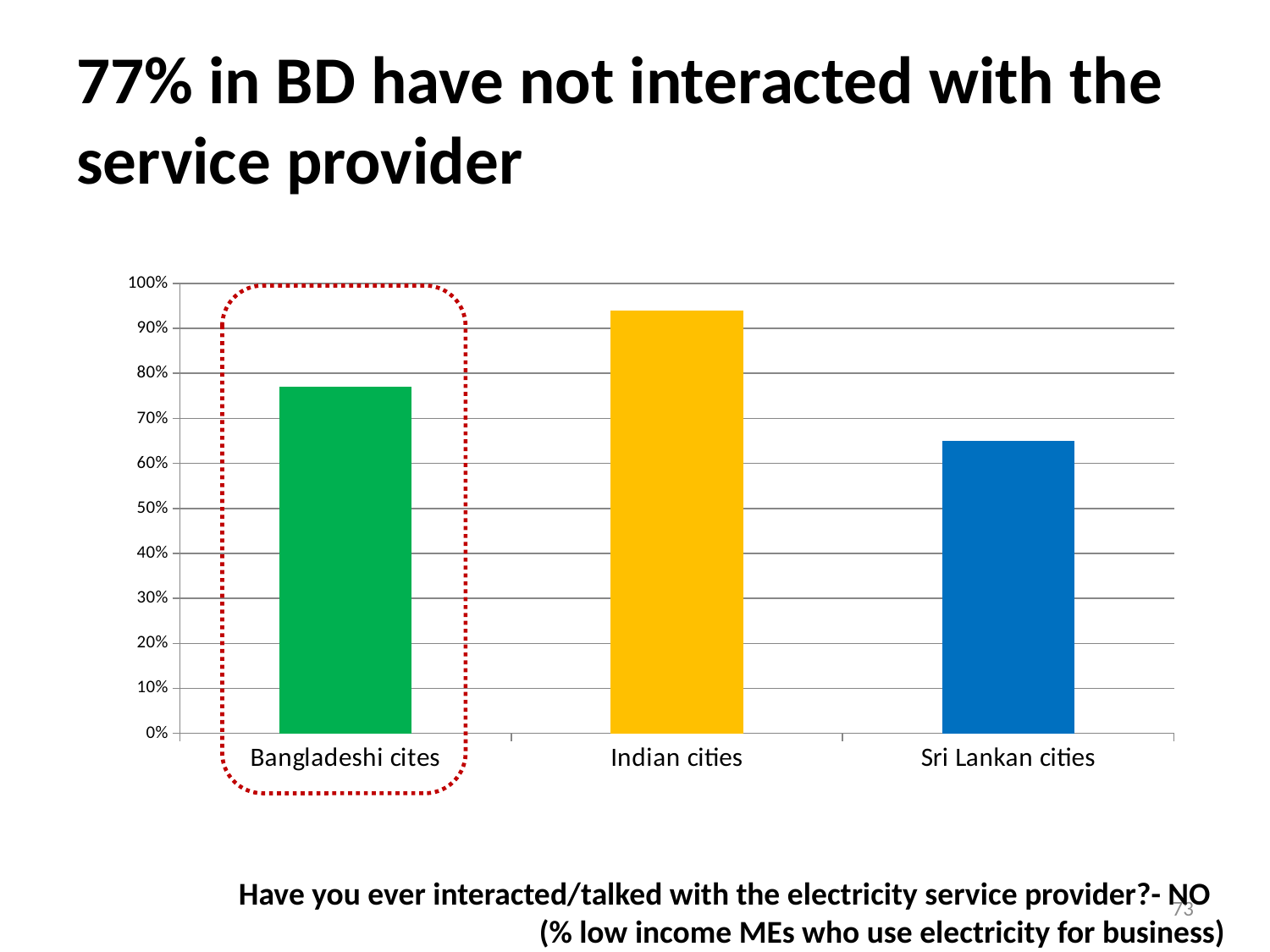
Which is larger, the value for Bangladeshi cites or the value for Indian cities? Indian cities Is the value for Bangladeshi cites greater or less than 80%? less Which category's bar is enclosed by a red dotted outline? Bangladeshi cites Is the value for Indian cities greater or less than 90%? greater Which is larger, the value for Indian cities or the value for Sri Lankan cities? Indian cities Which category has the highest bar in the chart? Indian cities Is the value for Sri Lankan cities greater or less than 70%? less How many categories are plotted on the x axis of the chart? 3 What colour is the bar for Indian cities? yellow According to the slide, what is the value for Bangladeshi cites? 77% Which category has the lowest bar in the chart? Sri Lankan cities What type of chart is shown on the slide? bar chart